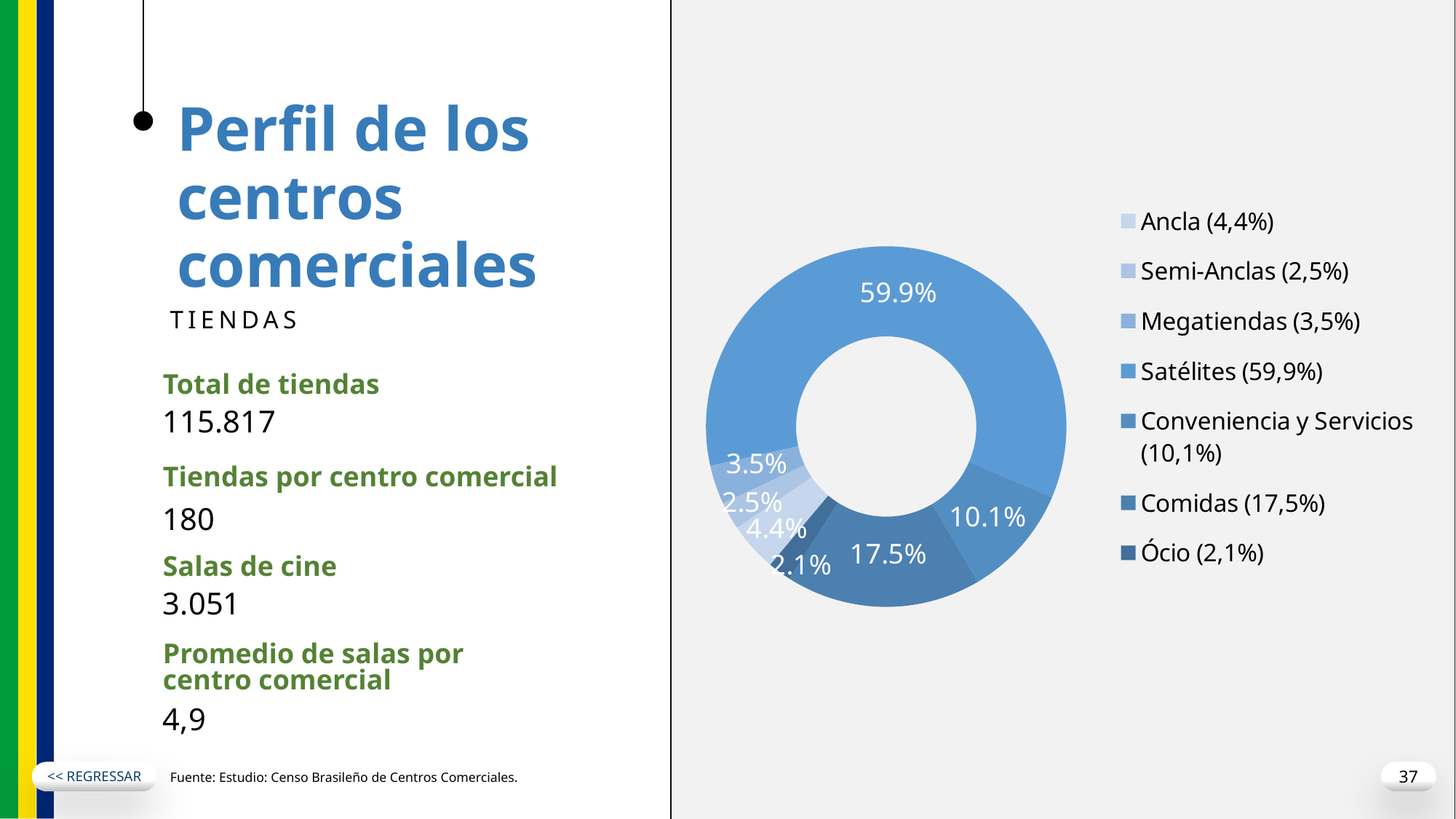
What is the legend entry listed first in the chart's legend? Ancla (4,4%) What is the value shown for Satélites? 59.9% Which category has the smallest share of the chart? Ócio How many categories does the chart show? 7 What is the difference between the shares of Comidas and Conveniencia y Servicios? 7.4% What is the value shown for Ancla? 4.4% Which category has the largest share of the chart? Satélites What share of the chart does Ócio represent? 2.1% What is the value shown for Comidas? 17.5% What is the value shown for Conveniencia y Servicios? 10.1% What kind of chart is shown on the slide? Doughnut (pie) chart Which is larger, the share for Megatiendas or the share for Semi-Anclas? Megatiendas